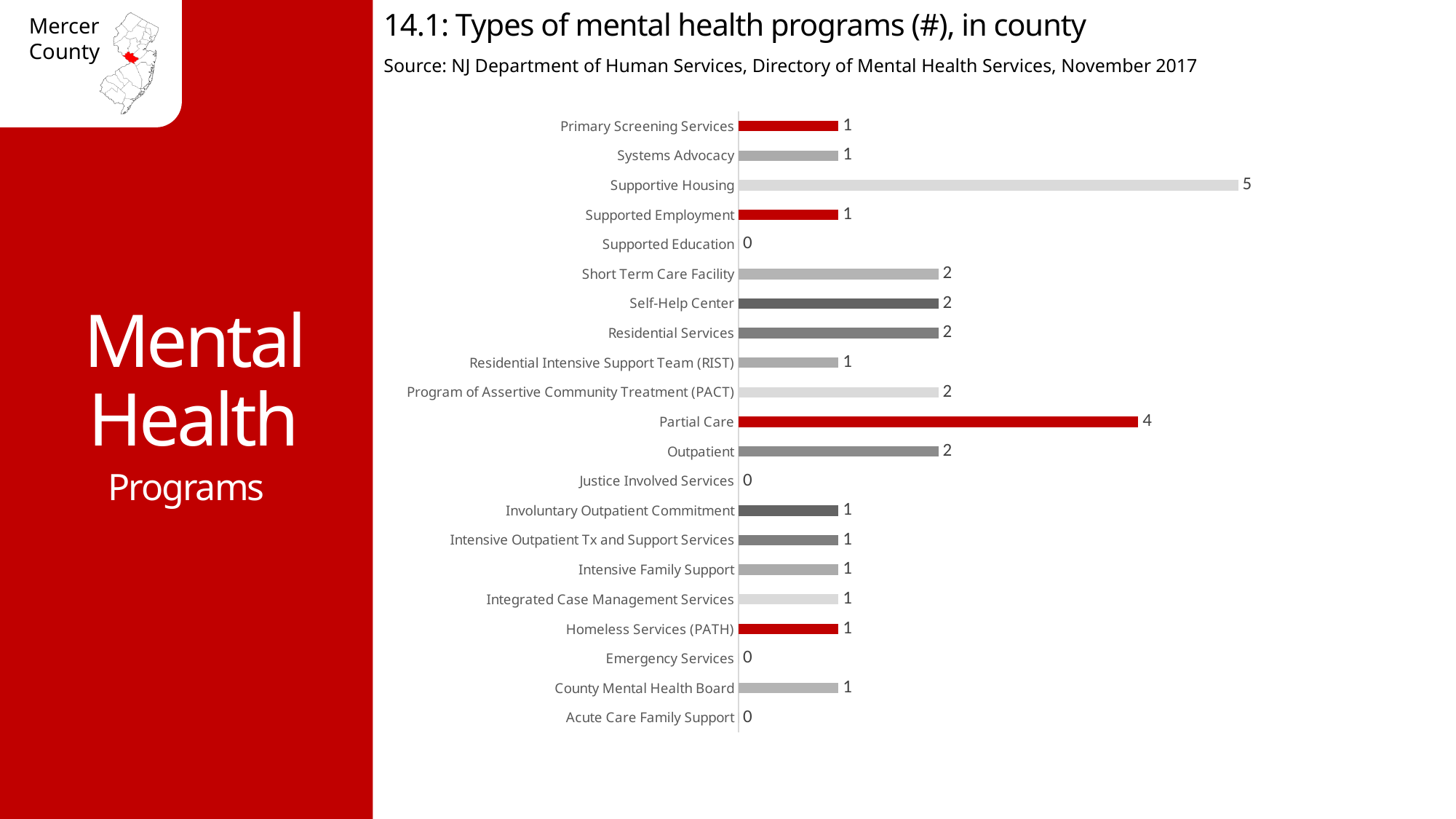
Which program type has the highest number of programs? Supportive Housing What is the title of the chart? 14.1: Types of mental health programs (#), in county What is the difference between the values for Supportive Housing and Partial Care? 1 What is the value for Homeless Services (PATH)? 1 How many Supportive Housing programs are shown? 5 How many program types (categories) are listed in the chart? 21 What type of chart is shown on the slide? bar chart Which is larger, the value for Self-Help Center or the value for Systems Advocacy? Self-Help Center What is the difference between the values for Partial Care and Short Term Care Facility? 2 How many Partial Care programs are shown? 4 What is the value for Emergency Services? 0 What is the value for Outpatient? 2